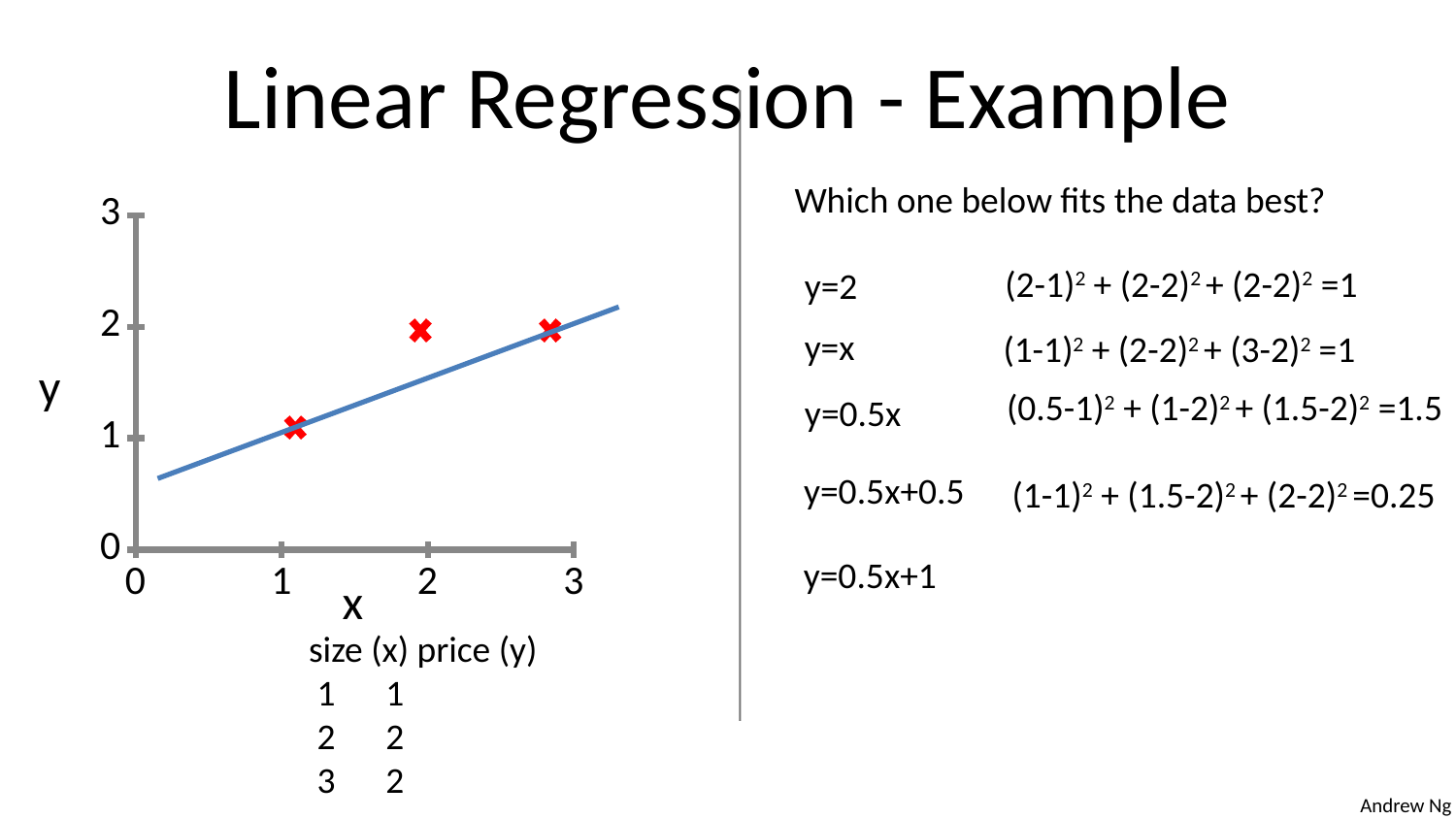
How many data points are plotted on the chart? 3 According to the data table under the chart, what is the price (y) when size (x) is 2? 2 Do the plotted y values generally rise or fall as x increases? rise Using the data table, what is the difference between the price (y) at size 2 and the price (y) at size 1? 1 What kind of chart is shown on the slide? scatter chart Is the y value of the point plotted near x=3 greater or less than 1? greater Which plotted point has the lowest y value: the one at x=1, x=2 or x=3? x=1 Is the y value of the point at x=2 larger or smaller than the y value of the point at x=1? larger According to the data table under the chart, what is the price (y) when size (x) is 3? 2 What colour are the data point markers on the chart? red What is the highest tick value shown on the y axis of the chart? 3 According to the data table under the chart, what is the price (y) when size (x) is 1? 1